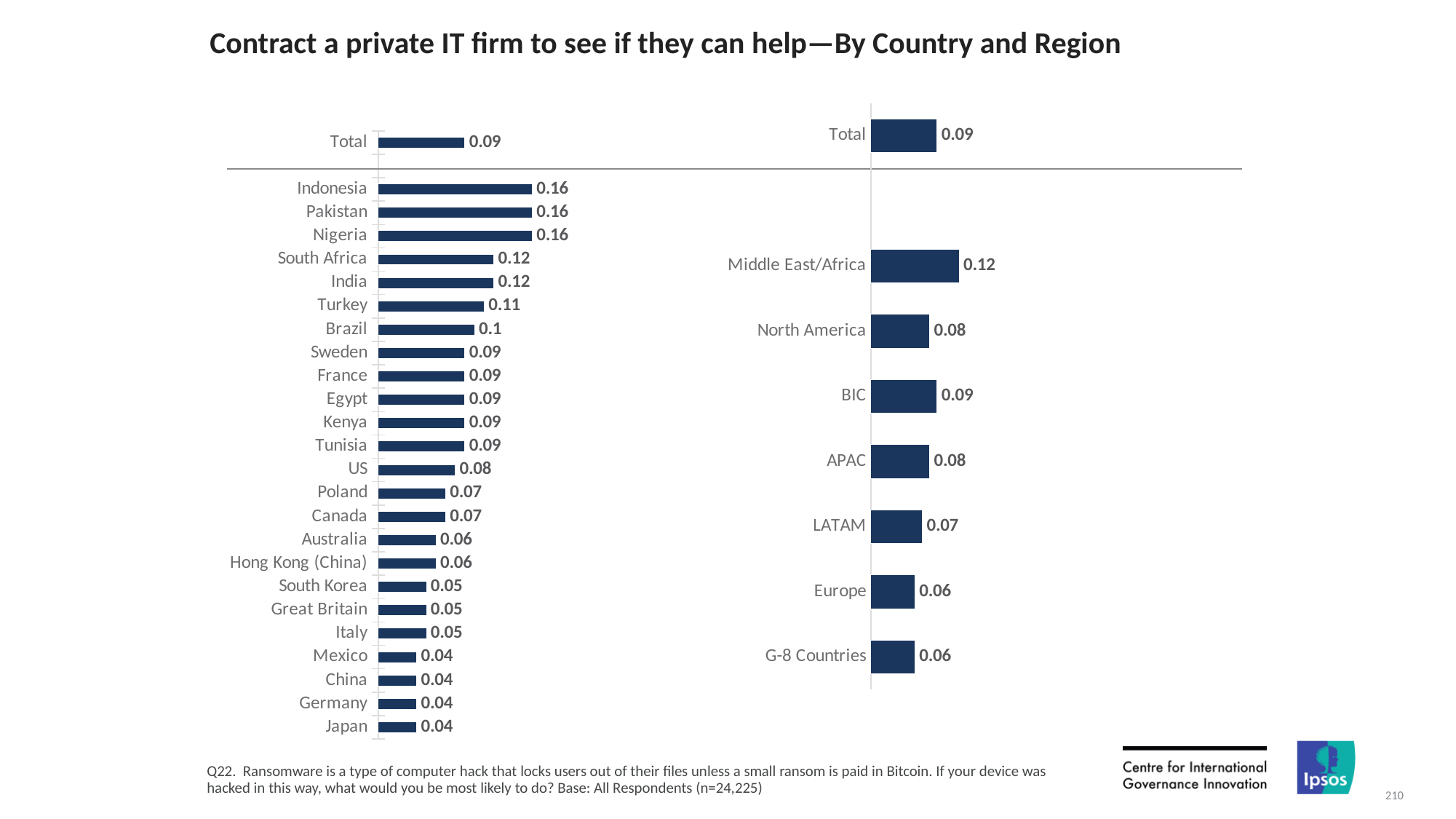
In the right chart (by region), what is the value for LATAM? 0.07 How many countries (excluding Total) are shown in the left chart? 24 What type of chart is the left chart (by country)? Bar chart In the left chart (by country), which has the larger value, US or Canada? US In the right chart (by region), which has the larger value, BIC or APAC? BIC In the left chart (by country), what is the difference between the values for Indonesia and South Africa? 0.04 In the right chart (by region), what is the difference between the values for Middle East/Africa and Europe? 0.06 In the left chart (by country), what is the value for Turkey? 0.11 In the left chart (by country), what is the value for Brazil? 0.1 In the right chart (by region), which region has the highest value? Middle East/Africa How many regions (excluding Total) are shown in the right chart? 7 In the left chart (by country), what is the value for Japan? 0.04